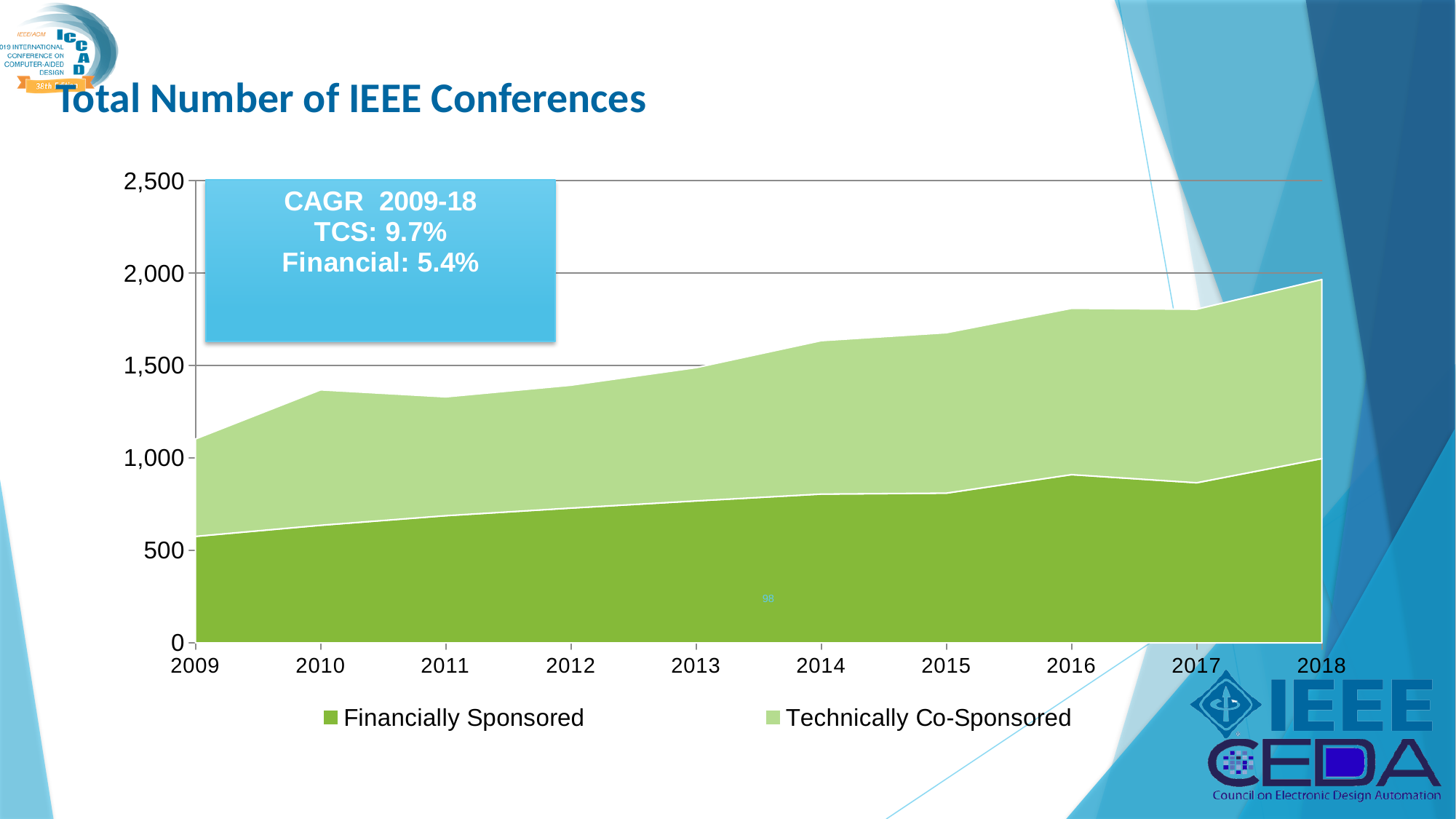
Is the total number of conferences in 2018 greater or less than 2,000? less What kind of chart is shown on the slide? Stacked area chart How many years are shown on the x axis? 10 What CAGR for 2009-18 does the text box give for TCS? 9.7% In which year is the total number of conferences highest? 2018 Does the total number of conferences generally rise or fall from 2009 to 2018? rise What is the title of the chart? Total Number of IEEE Conferences In which year is the total number of conferences lowest? 2009 Is the value for Financially Sponsored conferences in 2009 greater or less than 500? greater Which is larger, the total number of conferences in 2009 or in 2018? 2018 Is the total number of conferences in 2014 greater or less than 1,500? greater How many series does the legend list? 2